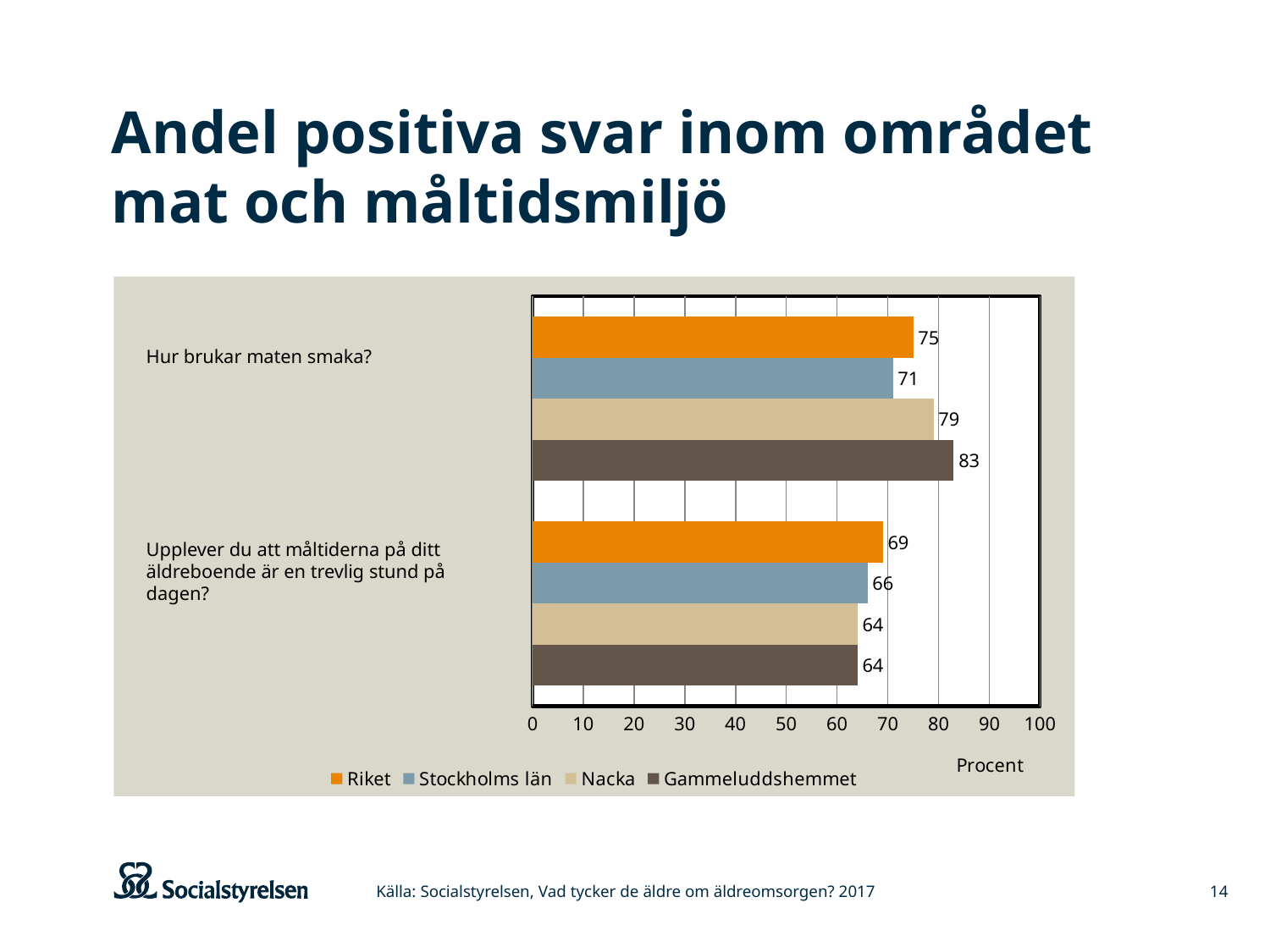
What is the difference between the Riket and Nacka values for "Upplever du att måltiderna på ditt äldreboende är en trevlig stund på dagen?"? 5 What kind of chart is shown on the slide? Bar chart What is the difference between the Gammeluddshemmet and Riket values for "Hur brukar maten smaka?"? 8 How many series does the legend list? 4 For "Upplever du att måltiderna på ditt äldreboende är en trevlig stund på dagen?", which is larger: Riket or Stockholms län? Riket Which series has the lowest value for "Hur brukar maten smaka?"? Stockholms län What is the value for Gammeluddshemmet for "Hur brukar maten smaka?"? 83 What is the label of the x axis? Procent Which series has the highest value for "Hur brukar maten smaka?"? Gammeluddshemmet What is the value for Stockholms län for "Hur brukar maten smaka?"? 71 Is the Nacka value for "Hur brukar maten smaka?" greater or less than 70? greater What is the value for Riket for "Upplever du att måltiderna på ditt äldreboende är en trevlig stund på dagen?"? 69